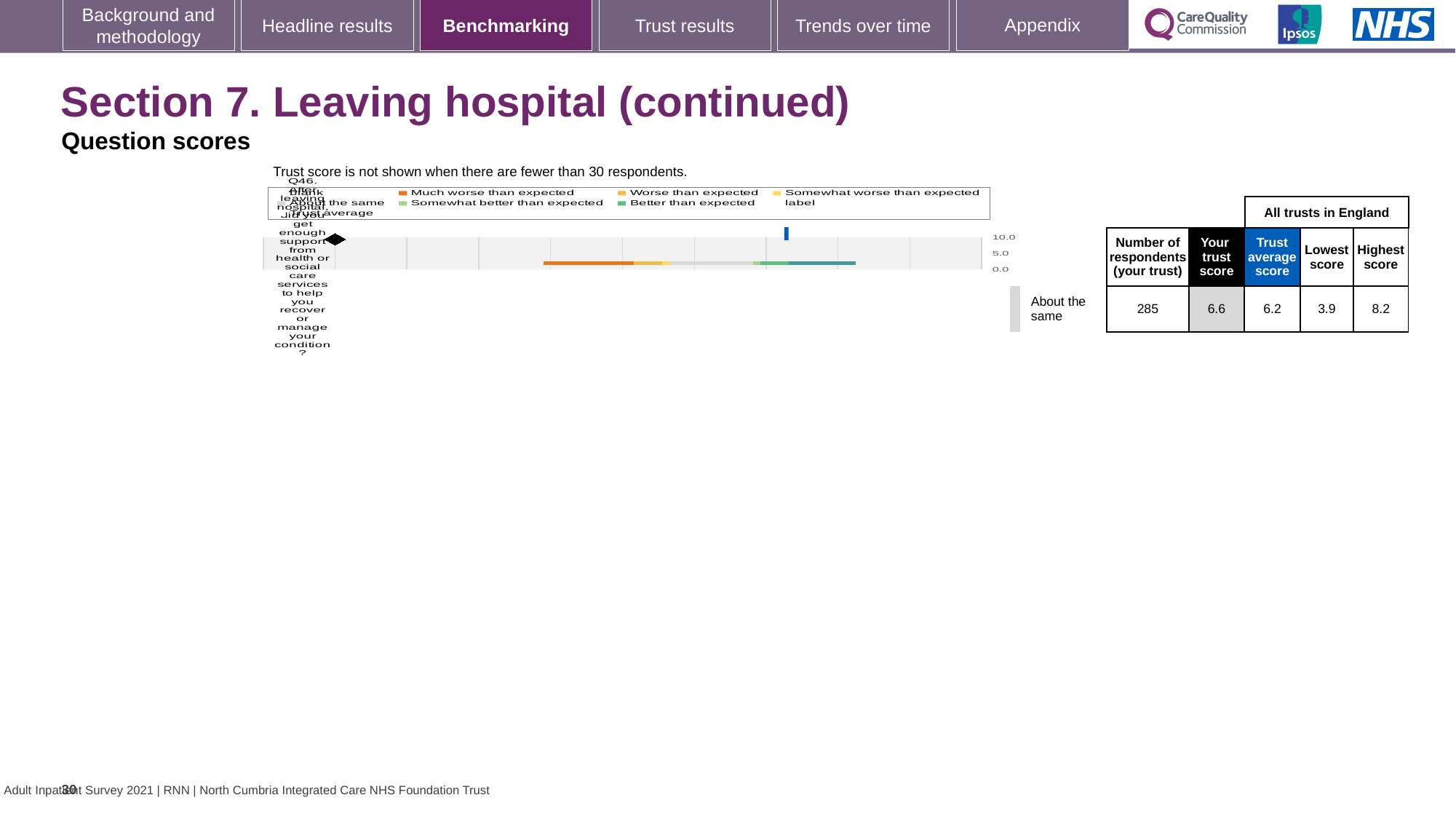
What kind of chart is shown on the slide? bar chart What is the trust average score for Q46 shown in the table next to the chart? 6.2 What is the difference between the trust score and the trust average score for Q46? 0.4 How many respondents from the trust answered Q46? 285 How many questions (categories) are plotted in the chart? 1 Which is larger for Q46: the trust's own score or the trust average score? the trust's own score What is the trust score for Q46 shown in the table next to the chart? 6.6 What is the lowest score across all trusts in England for Q46? 3.9 What is the difference between the highest score and the lowest score for Q46? 4.3 What colour is the legend entry 'Much worse than expected'? orange What is the highest value shown on the chart's score axis? 10.0 What is the highest score across all trusts in England for Q46? 8.2